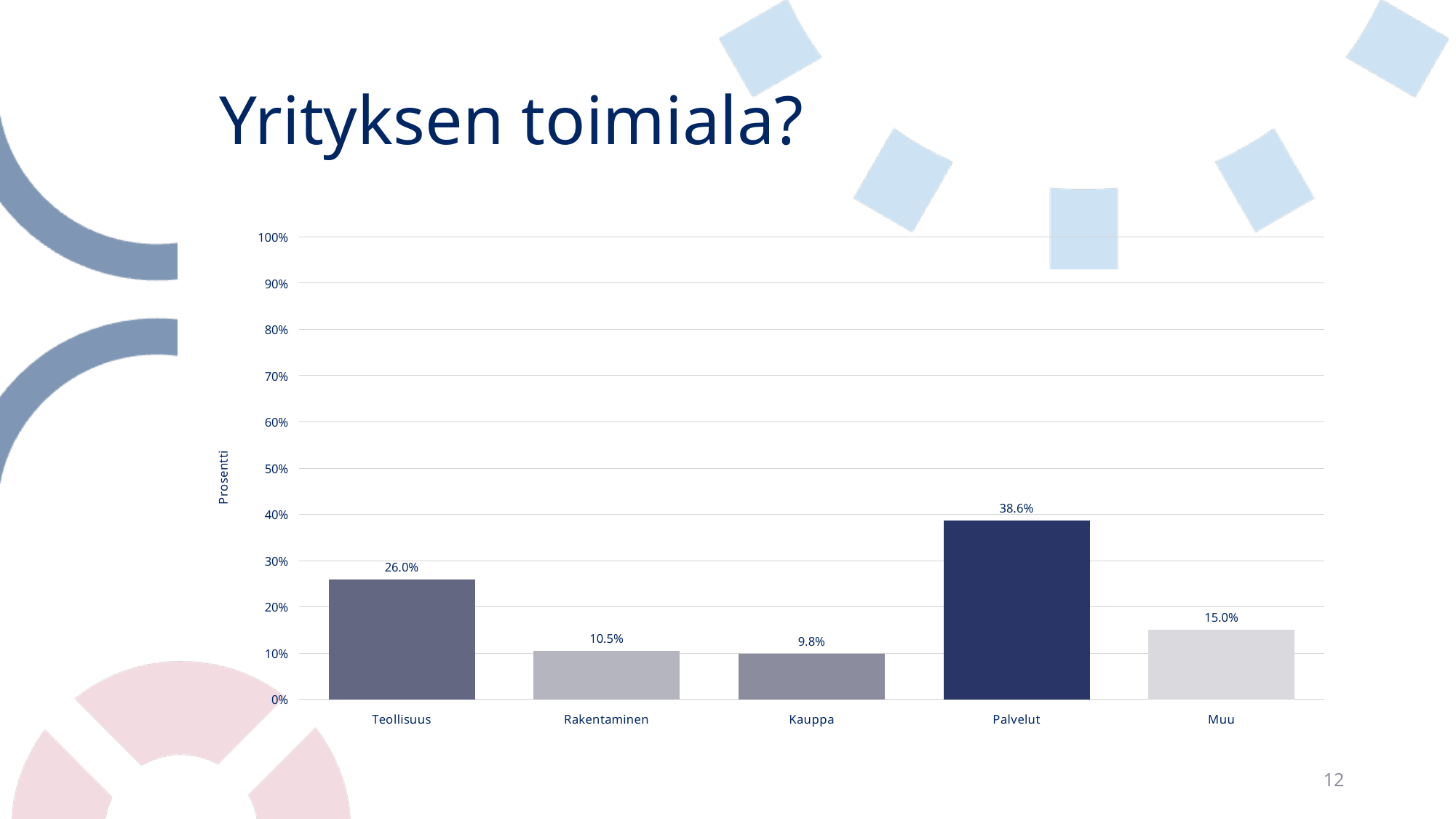
What is the difference between the values for Palvelut and Teollisuus? 12.6% What is the value for Teollisuus? 26.0% What is the value for Muu? 15.0% What is the value for Palvelut? 38.6% Which category has the lowest value? Kauppa Which category has the highest value? Palvelut What kind of chart is shown on the slide? bar chart How many categories are shown on the x axis? 5 What is the value for Kauppa? 9.8% Which is larger, the value for Teollisuus or the value for Muu? Teollisuus What is the difference between the values for Muu and Rakentaminen? 4.5% Is the value for Palvelut greater or less than 30%? greater